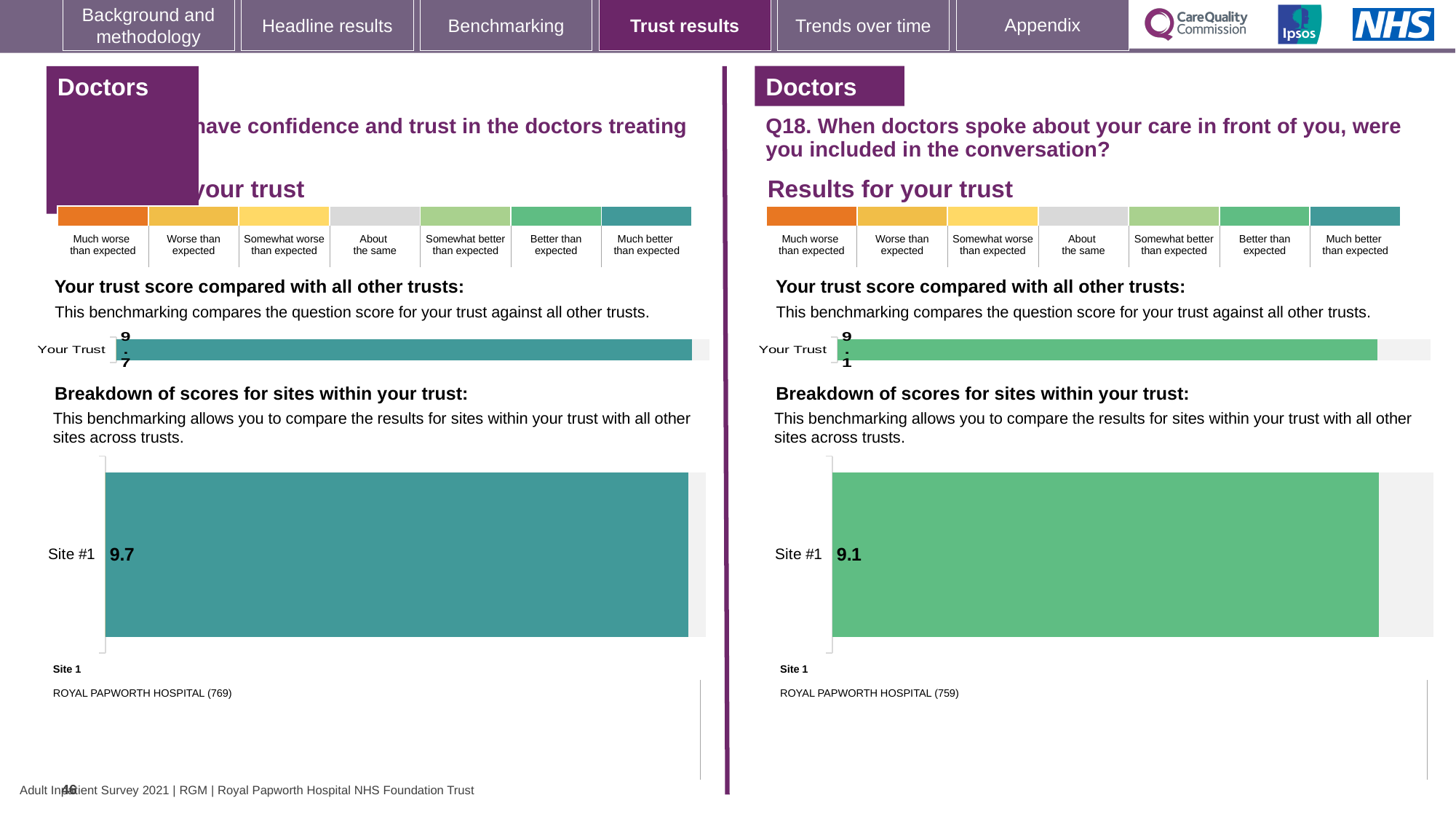
What is the difference between the Your Trust score on the left-hand side (9.7) and the Your Trust score on the right-hand side (9.1)? 0.6 In the right-hand (Q18) breakdown chart, which site is labelled as Site 1 below the chart? ROYAL PAPWORTH HOSPITAL (759) On the left-hand side of the slide, what is the score shown for Your Trust in the 'Your trust score compared with all other trusts' chart? 9.7 Which is larger: the Site #1 score in the left-hand breakdown chart or the Site #1 score in the right-hand (Q18) breakdown chart? The left-hand chart (9.7) In the left-hand breakdown chart, which site is labelled as Site 1 below the chart? ROYAL PAPWORTH HOSPITAL (769) Is the Your Trust score in the right-hand (Q18) chart greater or less than 9.5? less On the right-hand side of the slide (Q18), what is the score shown for Your Trust in the 'Your trust score compared with all other trusts' chart? 9.1 How many sites are shown in the 'Breakdown of scores for sites within your trust' chart on the right-hand side (Q18)? 1 In the 'Breakdown of scores for sites within your trust' chart on the left-hand side, what is the score for Site #1? 9.7 What type of chart is used to show the Site #1 score in the left-hand 'Breakdown of scores for sites within your trust' section? Bar chart In the 'Breakdown of scores for sites within your trust' chart on the right-hand side (Q18), what is the score for Site #1? 9.1